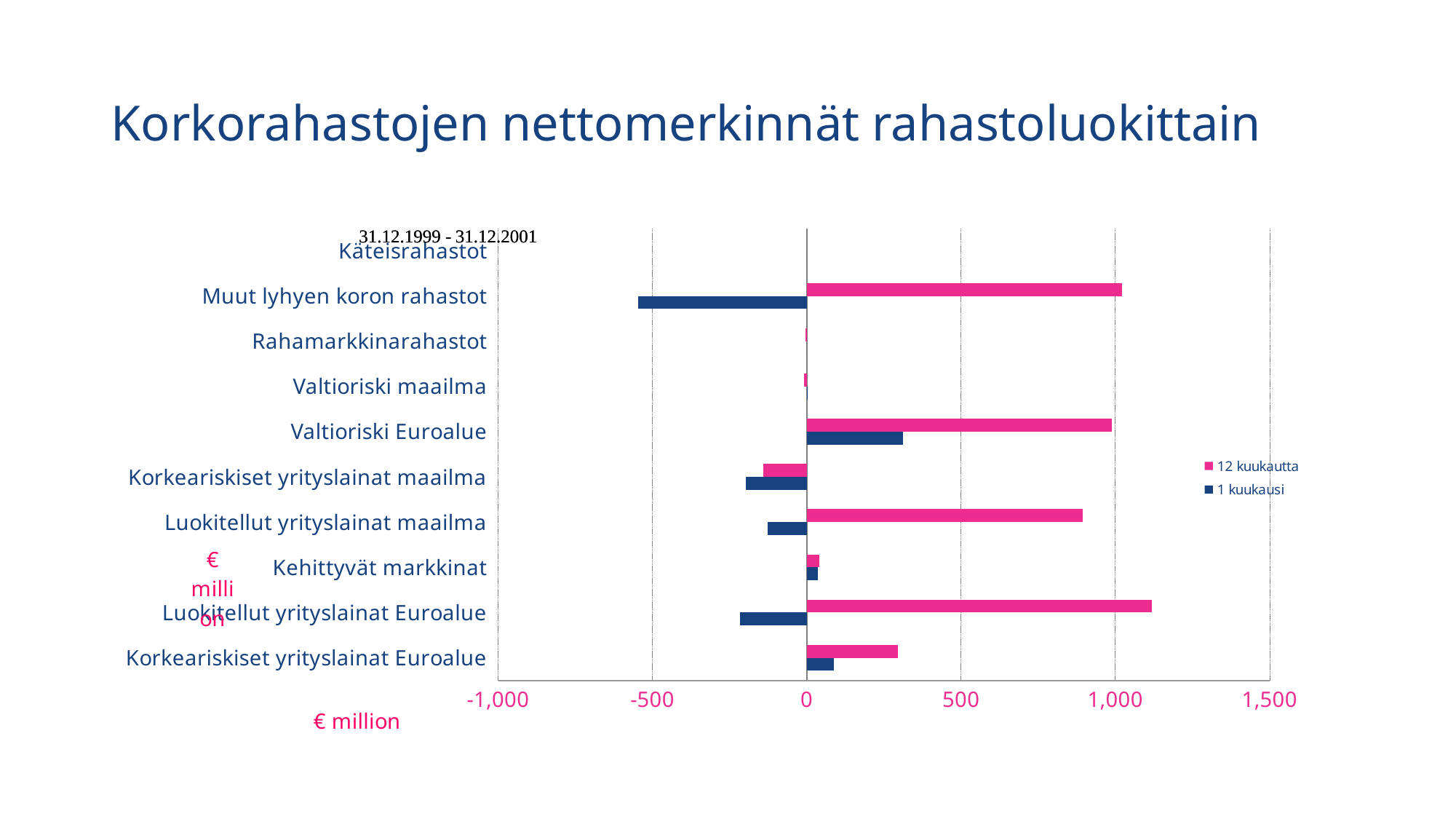
For Korkeariskiset yrityslainat Euroalue, which series has the larger value: 12 kuukautta or 1 kuukausi? 12 kuukautta Is the 12 kuukautta value for Korkeariskiset yrityslainat Euroalue greater or less than 500? less Is the 12 kuukautta value for Muut lyhyen koron rahastot greater or less than 500? greater Which category has the lowest value for the 1 kuukausi series? Muut lyhyen koron rahastot How many fund categories are listed on the vertical axis? 10 What kind of chart is shown on the slide? bar chart Which category has the highest value for the 1 kuukausi series? Valtioriski Euroalue Which category has the highest value for the 12 kuukautta series? Luokitellut yrityslainat Euroalue What unit is shown on the horizontal axis of the chart? € million Is the 1 kuukausi value for Muut lyhyen koron rahastot greater or less than -500? less Which is larger for the 12 kuukautta series: Valtioriski Euroalue or Luokitellut yrityslainat maailma? Valtioriski Euroalue How many series does the legend list? 2